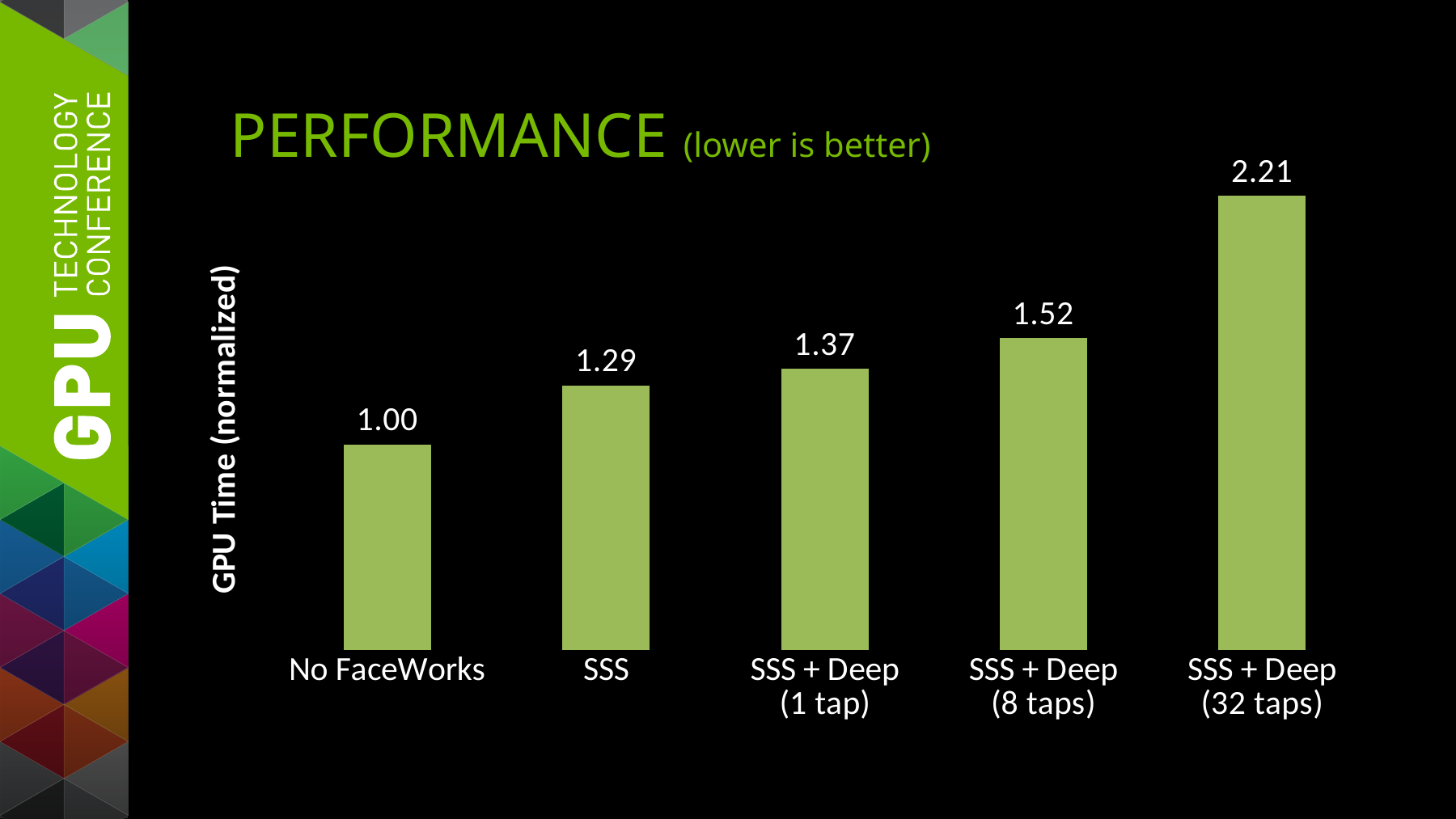
What is the difference in normalized GPU time between SSS + Deep (32 taps) and No FaceWorks? 1.21 What is the difference in normalized GPU time between SSS + Deep (8 taps) and SSS + Deep (1 tap)? 0.15 What is the normalized GPU time for SSS + Deep (8 taps)? 1.52 What is the normalized GPU time for No FaceWorks? 1.00 Which has a higher normalized GPU time, SSS or SSS + Deep (1 tap)? SSS + Deep (1 tap) What is the normalized GPU time for SSS? 1.29 Do the values rise or fall from left to right across the categories? Rise Which category has the highest normalized GPU time? SSS + Deep (32 taps) Which category has the lowest normalized GPU time? No FaceWorks What is the normalized GPU time for SSS + Deep (32 taps)? 2.21 What kind of chart is shown on the slide? Bar chart How many categories are shown in the chart? 5